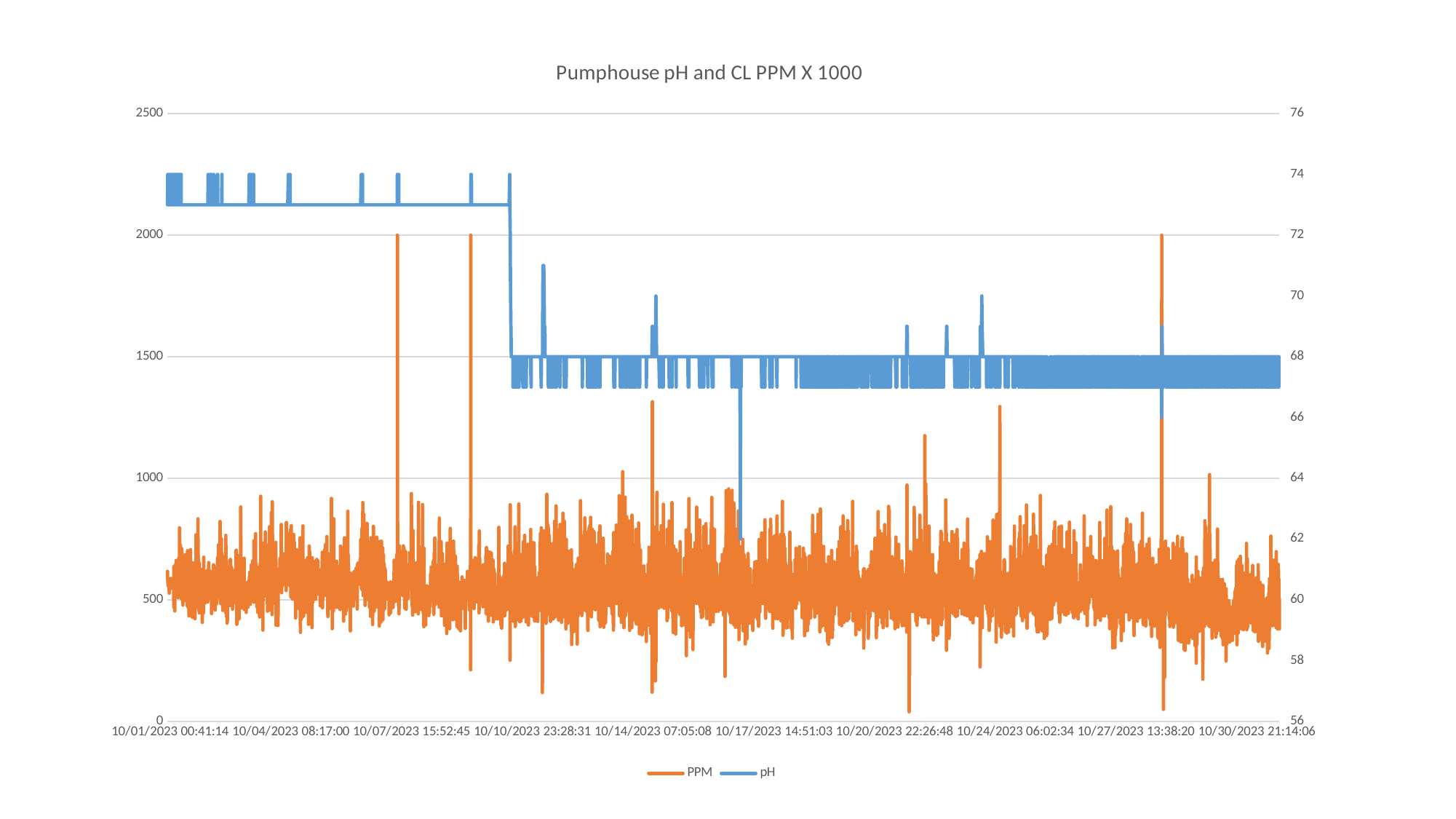
Does the pH series rise or fall overall from the start to the end of the chart? fall What is the maximum value shown on the right vertical axis? 76 Which series is drawn in orange? PPM Is the pH value at the start of the chart (around 10/01/2023) greater or less than 72? greater Is the highest PPM spike on the chart greater or less than 1500? greater How many date labels are shown along the x axis? 10 How many series does the legend list? 2 What is the title of the chart? Pumphouse pH and CL PPM X 1000 What is the maximum value shown on the left vertical axis? 2500 What is the minimum value shown on the right vertical axis? 56 Is the pH value at the end of the chart (around 10/30/2023) greater or less than 70? less What kind of chart is shown on the slide? line chart